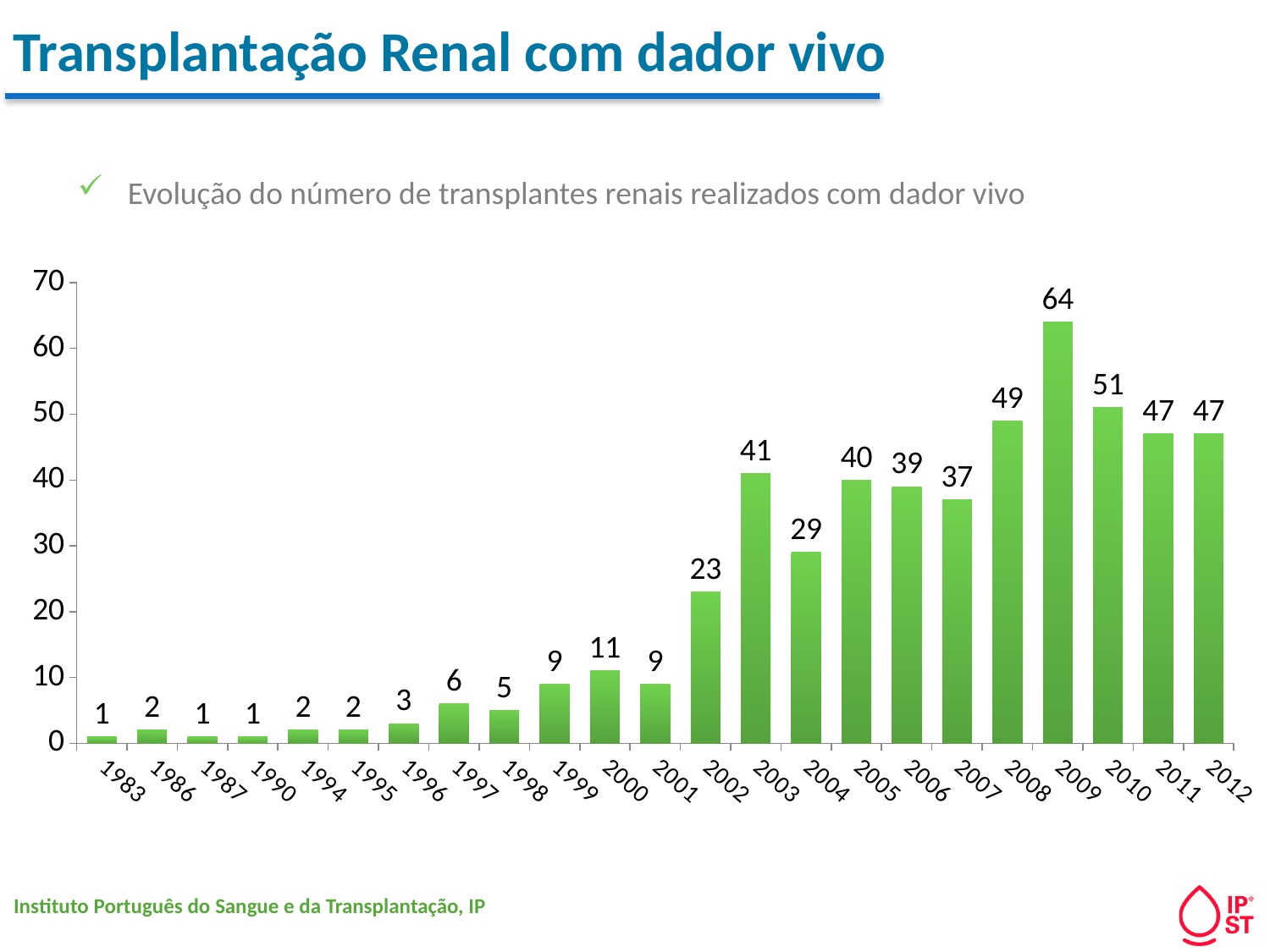
Which year has the highest value? 2009 What is the value for 2004? 29 What is the title of the slide? Transplantação Renal com dador vivo What is the difference between the values for 2009 and 2010? 13 What is the value for 2002? 23 How many years are shown on the x axis? 23 Do the values generally rise or fall from 1983 to 2009? rise What kind of chart is shown on the slide? bar chart Is the value for 2008 greater or less than 40? greater What is the difference between the values for 2003 and 2002? 18 Which is larger, the value for 2005 or the value for 2007? 2005 What is the value for 2009? 64